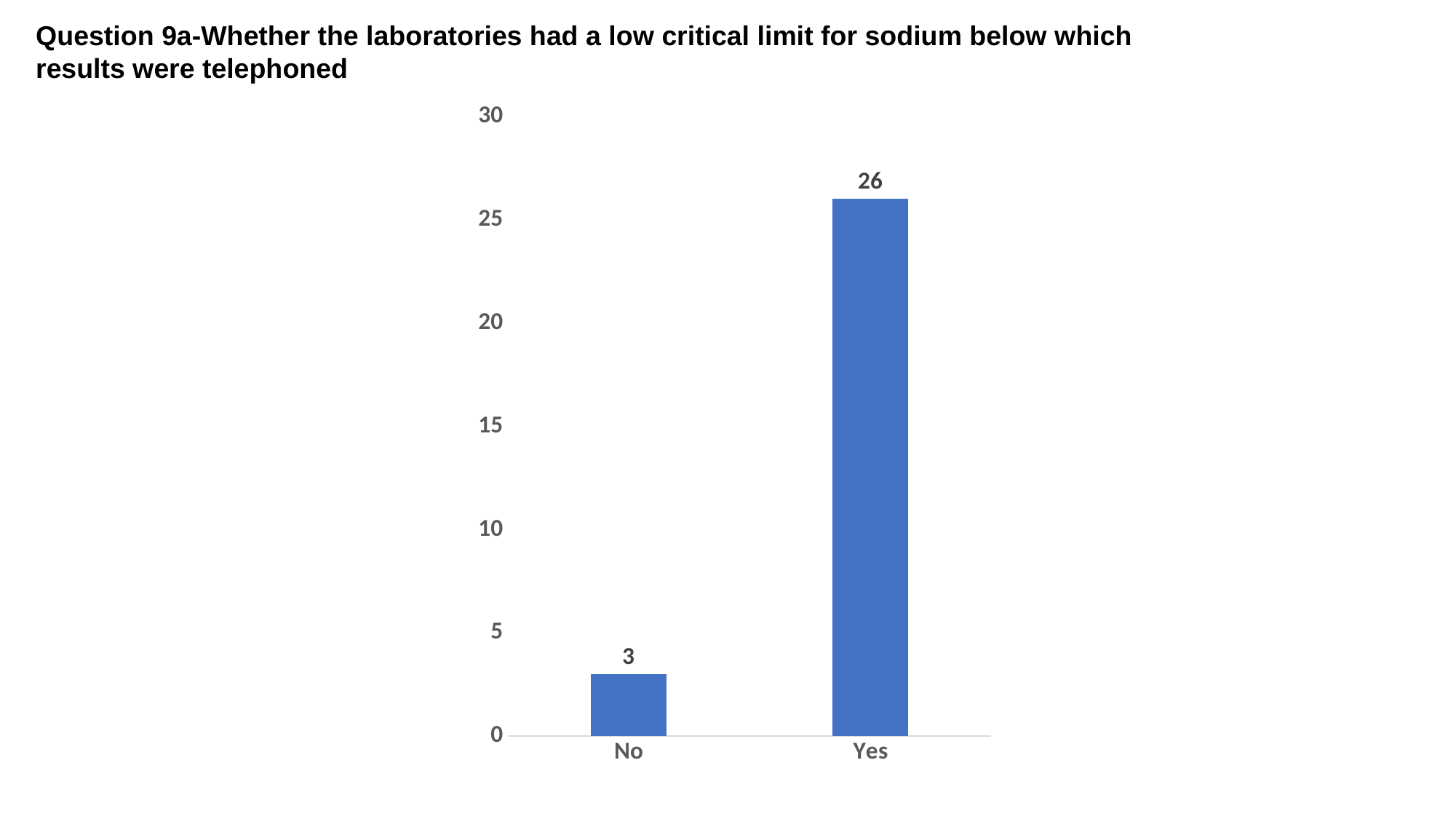
What is the value for the "Yes" category? 26 What is the total of the values for "No" and "Yes"? 29 How many categories are shown on the x axis? 2 What is the difference between the values for "Yes" and "No"? 23 Which category has the highest value? Yes Which category has the lowest value? No Is the value for "Yes" greater or less than 25? greater What kind of chart is shown on the slide? bar chart Is the value for "No" greater or less than 5? less What is the maximum value shown on the vertical axis? 30 What is the value for the "No" category? 3 Which is larger, the value for "Yes" or the value for "No"? Yes